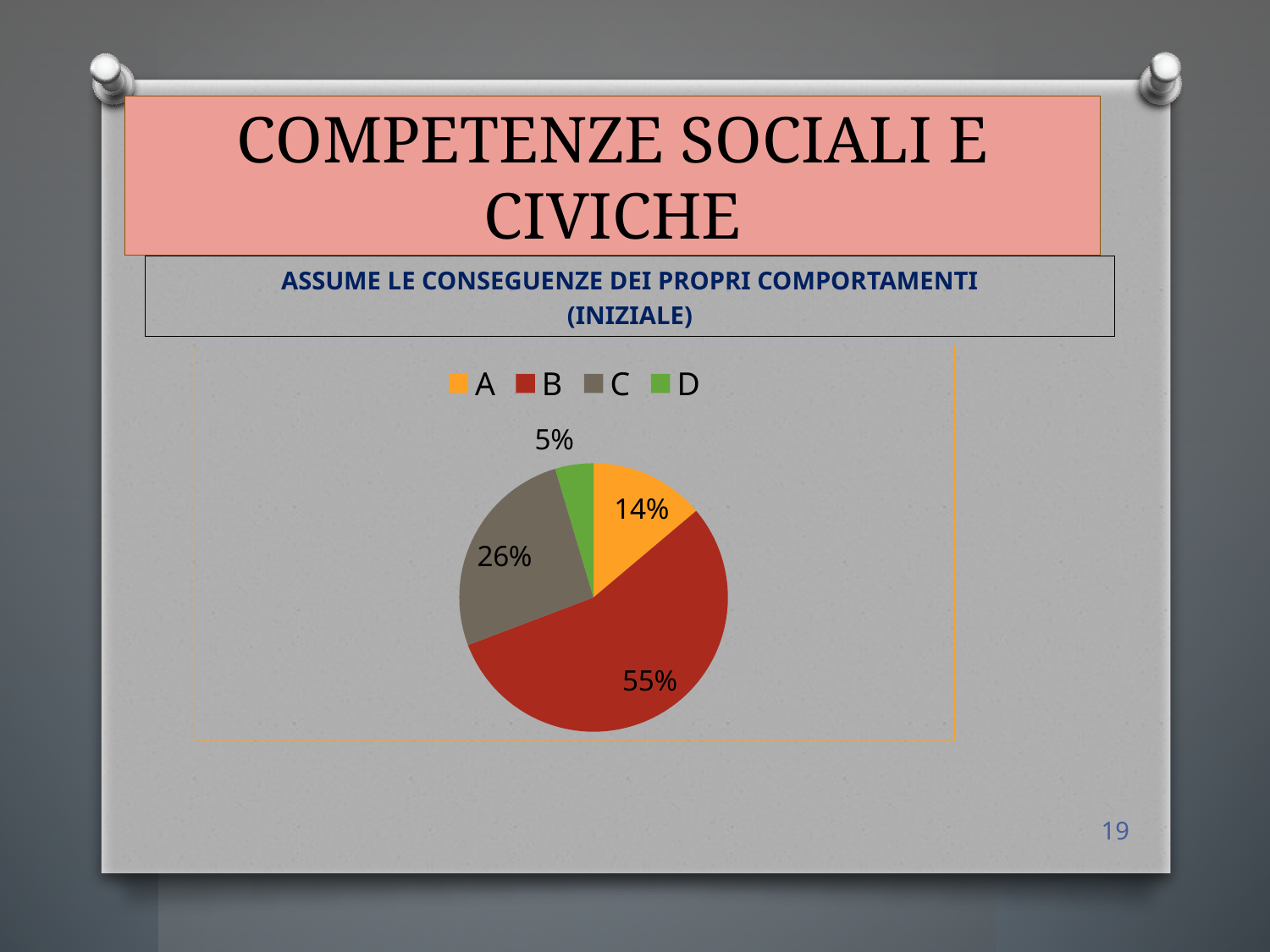
What is the difference in percentage points between category B and category C? 29 How many categories does the legend list? 4 Which is larger, the slice for A or the slice for C? C What share of the pie does category B have? 55% Which category has the largest slice of the pie? B How many slices does the pie chart have? 4 What share of the pie does category A have? 14% What share of the pie does category D have? 5% What kind of chart is shown on the slide? pie chart What colour is the slice for category B? red Which category has the smallest slice of the pie? D